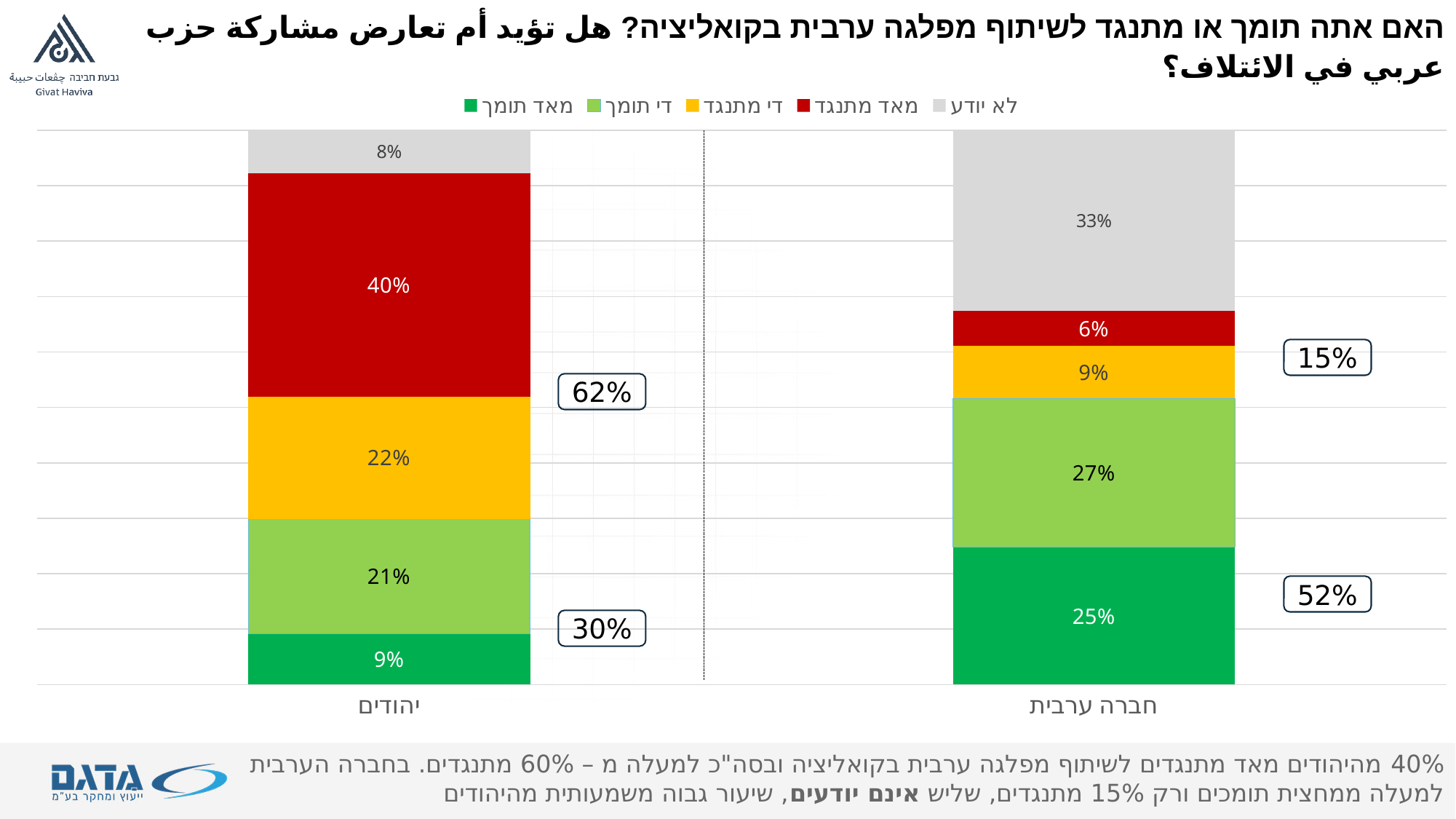
What percentage of יהודים answered די תומך? 21% How many series does the legend list? 5 What percentage of חברה ערבית answered מאד תומך? 25% What percentage of חברה ערבית answered לא יודע? 33% How many groups (bars) are shown on the x axis? 2 What is the combined share of מאד תומך and די תומך among חברה ערבית, as shown in the callout? 52% What type of chart is shown on the slide? Stacked bar chart What is the difference between the מאד מתנגד share for יהודים and for חברה ערבית? 34 percentage points Which group has a larger די תומך share, יהודים or חברה ערבית? חברה ערבית What percentage of יהודים answered מאד מתנגד? 40% Which response category has the smallest share among חברה ערבית? מאד מתנגד Which response category has the largest share among יהודים? מאד מתנגד